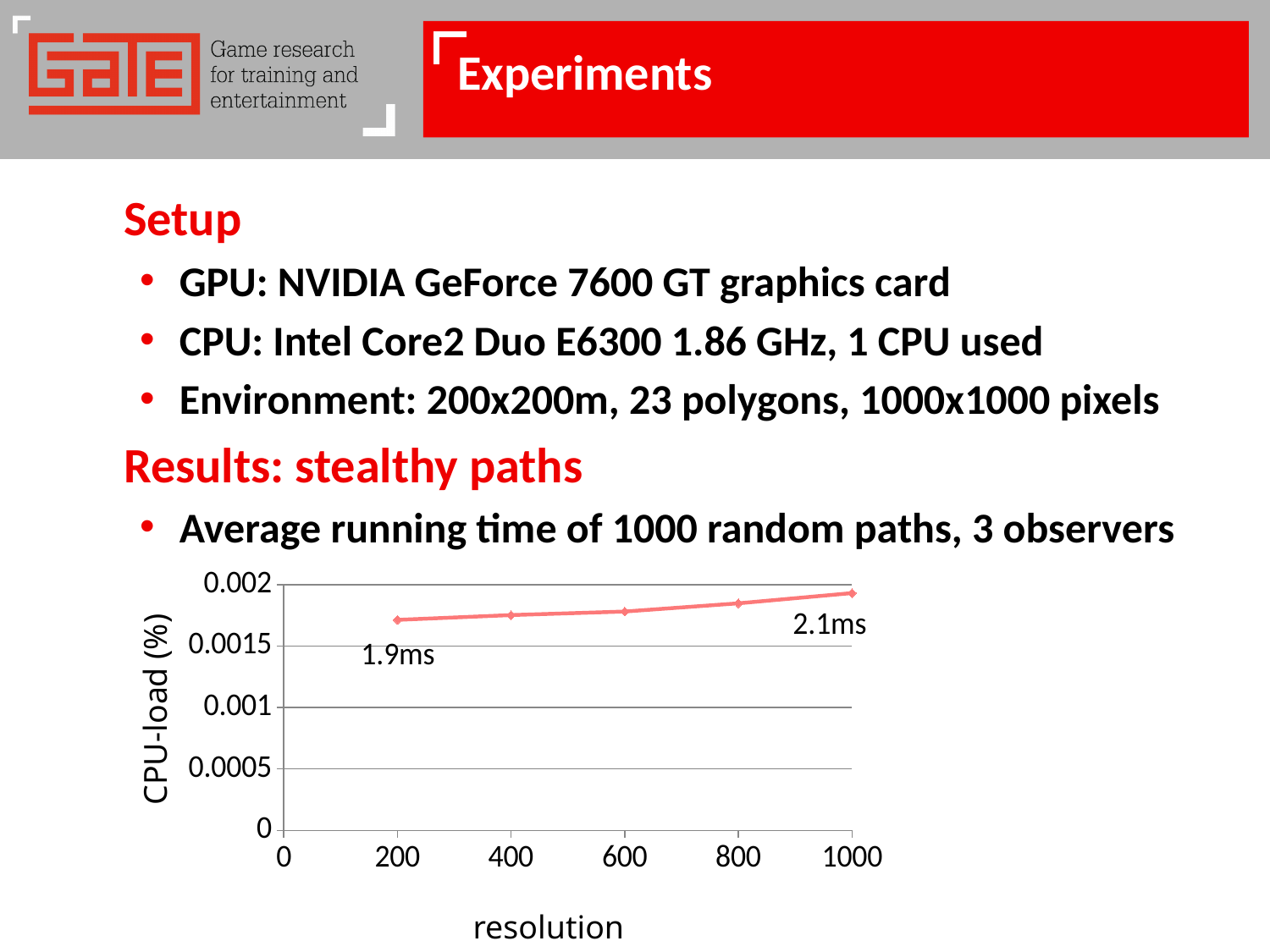
Which resolution has the lowest CPU-load value? 200 How many data points are plotted on the line? 5 What label is printed next to the data point at resolution 200? 1.9ms What kind of chart is shown on the slide? line chart Which resolution has the highest CPU-load value? 1000 Is the CPU-load value at resolution 200 greater or less than 0.0015? greater What is the title of the x axis of the chart? resolution What is the title of the y axis of the chart? CPU-load (%) What label is printed next to the data point at resolution 1000? 2.1ms Is the CPU-load value at resolution 600 greater or less than 0.001? greater Do the values rise or fall as resolution increases along the x axis? rise